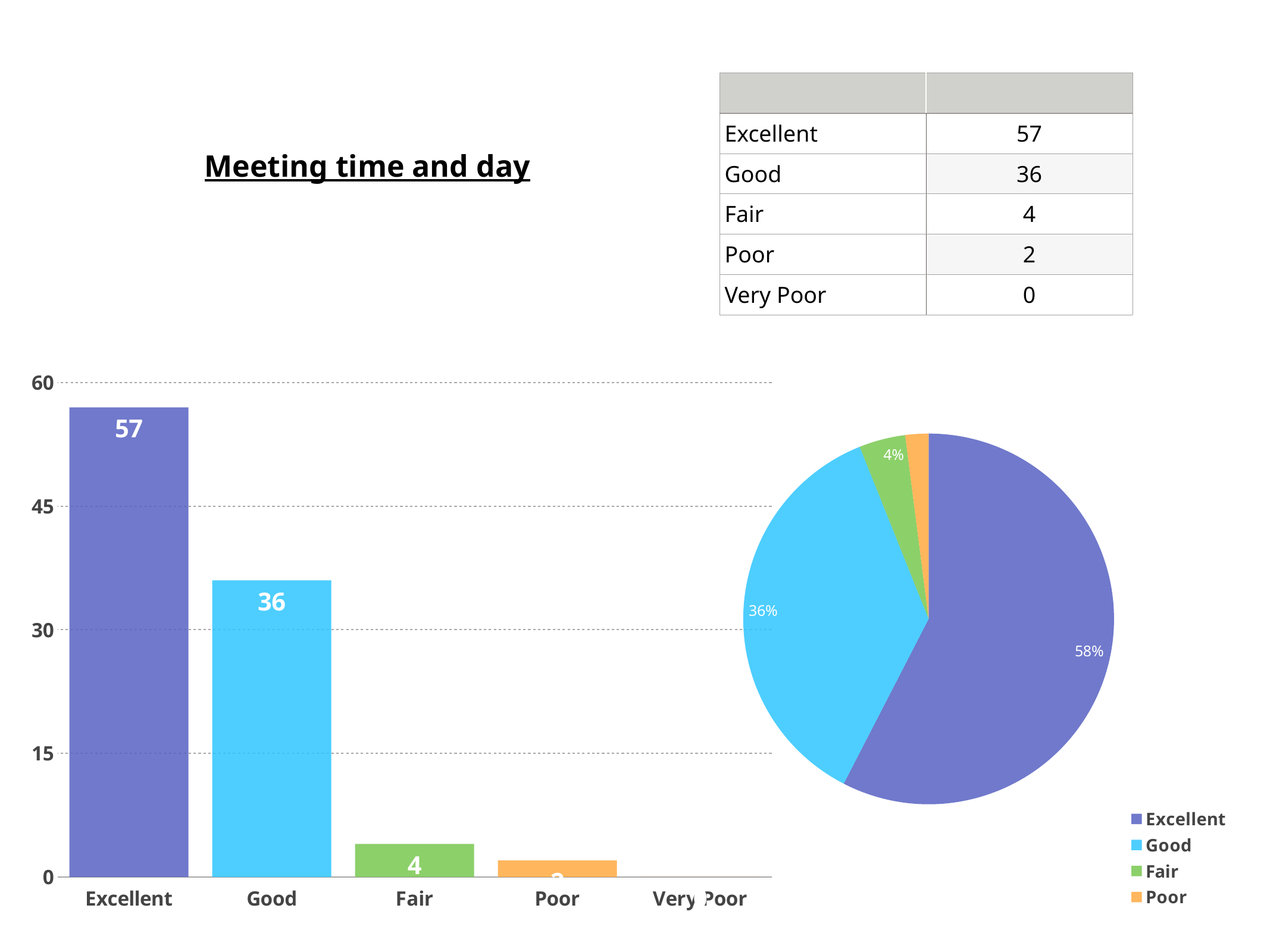
How many entries does the legend of the pie chart on the right list? 4 How many categories are shown on the x axis of the bar chart on the left? 5 In the bar chart on the left, what is the difference between the values for Excellent and Good? 21 In the bar chart on the left, what is the value for Fair? 4 In the bar chart on the left, which category has the highest value? Excellent In the bar chart on the left, what is the value for Excellent? 57 In the pie chart on the right, what share of the pie does the Good slice represent? 36% In the bar chart on the left, is the value for Poor greater or less than 15? less What kind of chart is the chart on the left of the slide? bar chart In the bar chart on the left, which is larger, the value for Good or the value for Fair? Good In the bar chart on the left, what is the value for Good? 36 In the bar chart on the left, which category has the lowest value? Very Poor